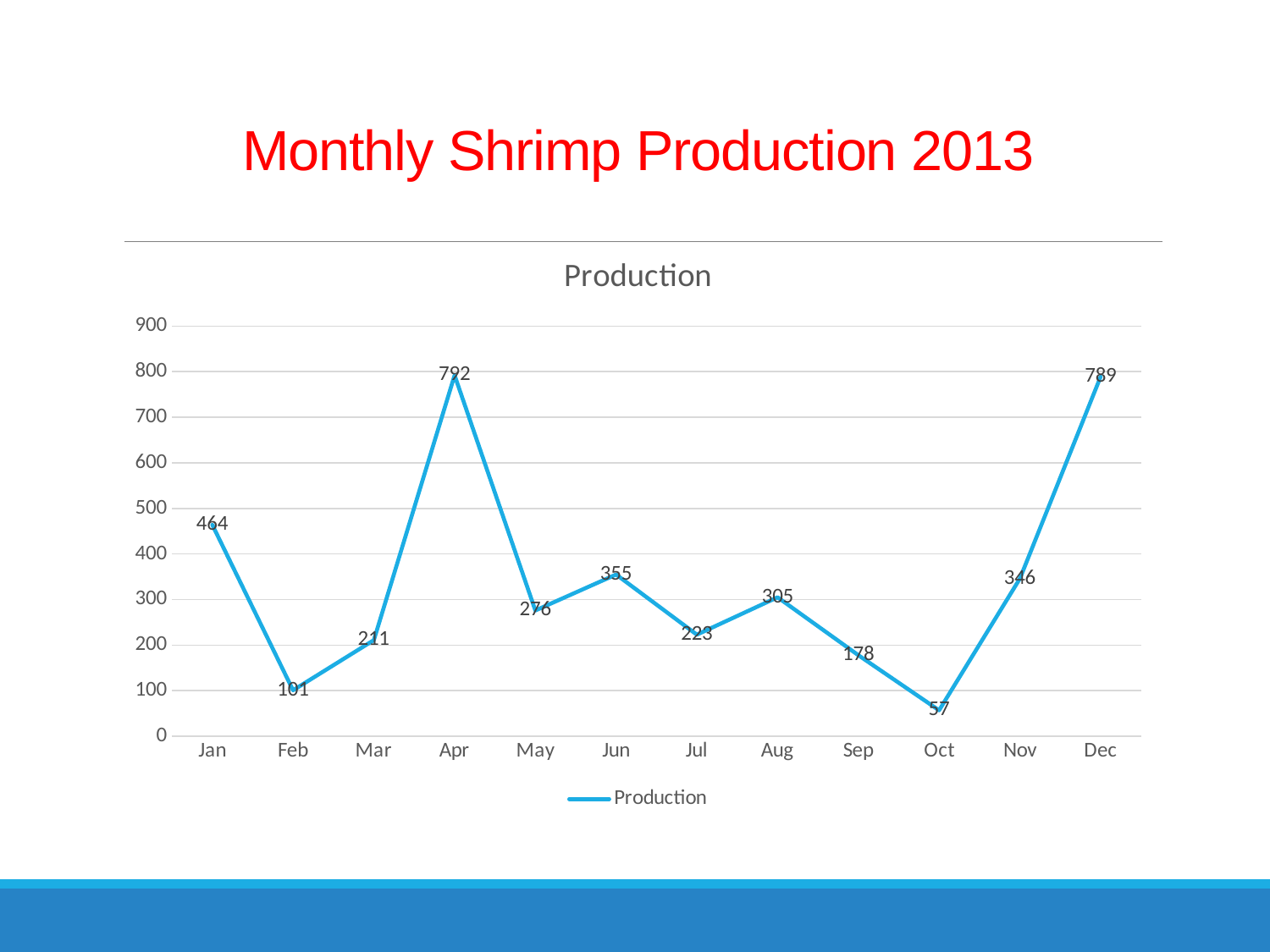
Which is larger, the production in Jun or the production in Aug? Jun What is the production value for Sep? 178 What is the difference between the production in Apr and the production in Dec? 3 Does the production rise or fall from Jan to Feb? Fall What is the production value for Apr? 792 What is the production value for Oct? 57 What kind of chart is shown on the slide? Line chart Is the production value for Nov greater or less than 300? greater What is the difference between the production in Jan and the production in Feb? 363 Which month has the lowest production? Oct Which month has the highest production? Apr How many months are plotted on the chart? 12